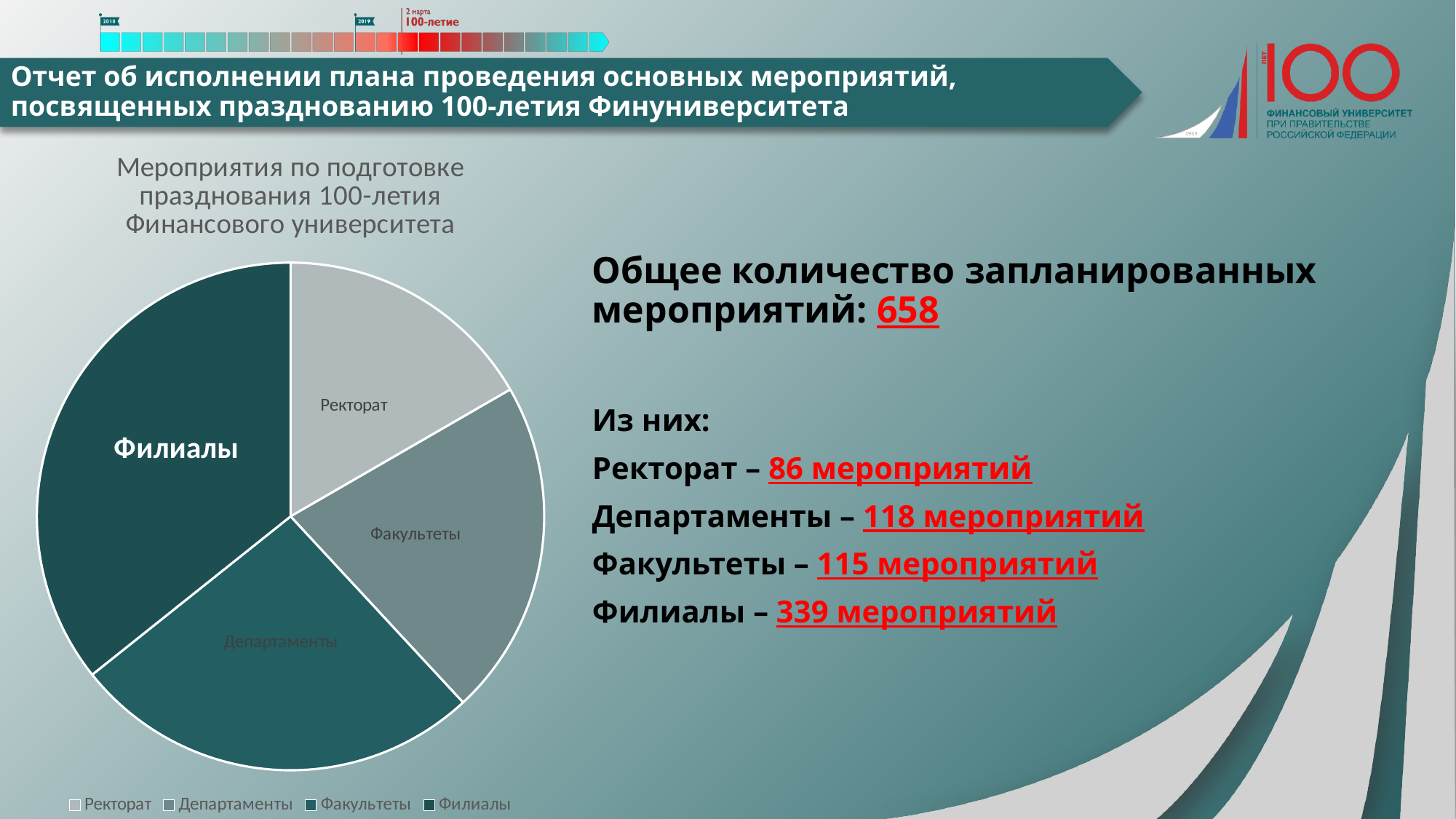
What is the title of the pie chart? Мероприятия по подготовке празднования 100-летия Финансового университета What kind of chart is shown on the slide? pie chart Does the Филиалы slice account for more or less than half of the pie chart? less How many events are planned for Департаменты? 118 мероприятий Which category has the smallest slice of the pie chart? Ректорат Which category has the largest slice of the pie chart? Филиалы What is the difference between the number of events for Филиалы and for Ректорат? 253 How many events are planned for Филиалы? 339 мероприятий How many categories does the pie chart have? 4 How many entries does the legend of the pie chart list? 4 How many events are planned for Ректорат? 86 мероприятий What is the total number of planned events shown on the slide? 658